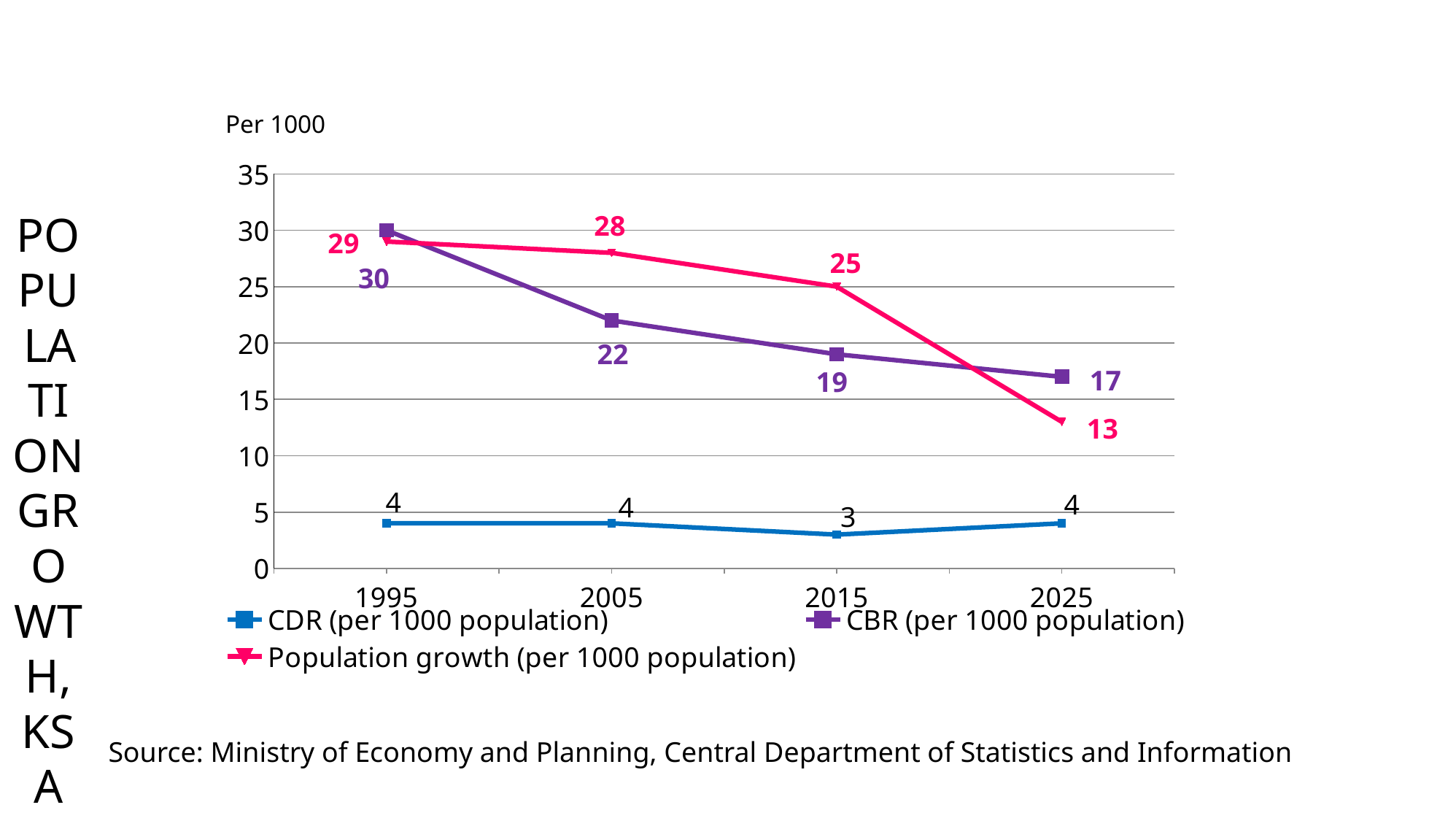
What kind of chart is shown on the slide? Line chart What is the difference between the CBR and CDR values in 1995? 26 How many series does the legend list? 3 What unit label is shown above the y axis? Per 1000 What is the CBR (per 1000 population) value in 2005? 22 In which year is the CBR (per 1000 population) series highest? 1995 In which year is the Population growth (per 1000 population) series lowest? 2025 Does the CBR (per 1000 population) series rise or fall from 1995 to 2025? Fall How many years are shown on the x axis? 4 What is the CDR (per 1000 population) value in 2015? 3 Which is larger in 2025: CBR (per 1000 population) or Population growth (per 1000 population)? CBR (per 1000 population) What is the Population growth (per 1000 population) value in 2025? 13